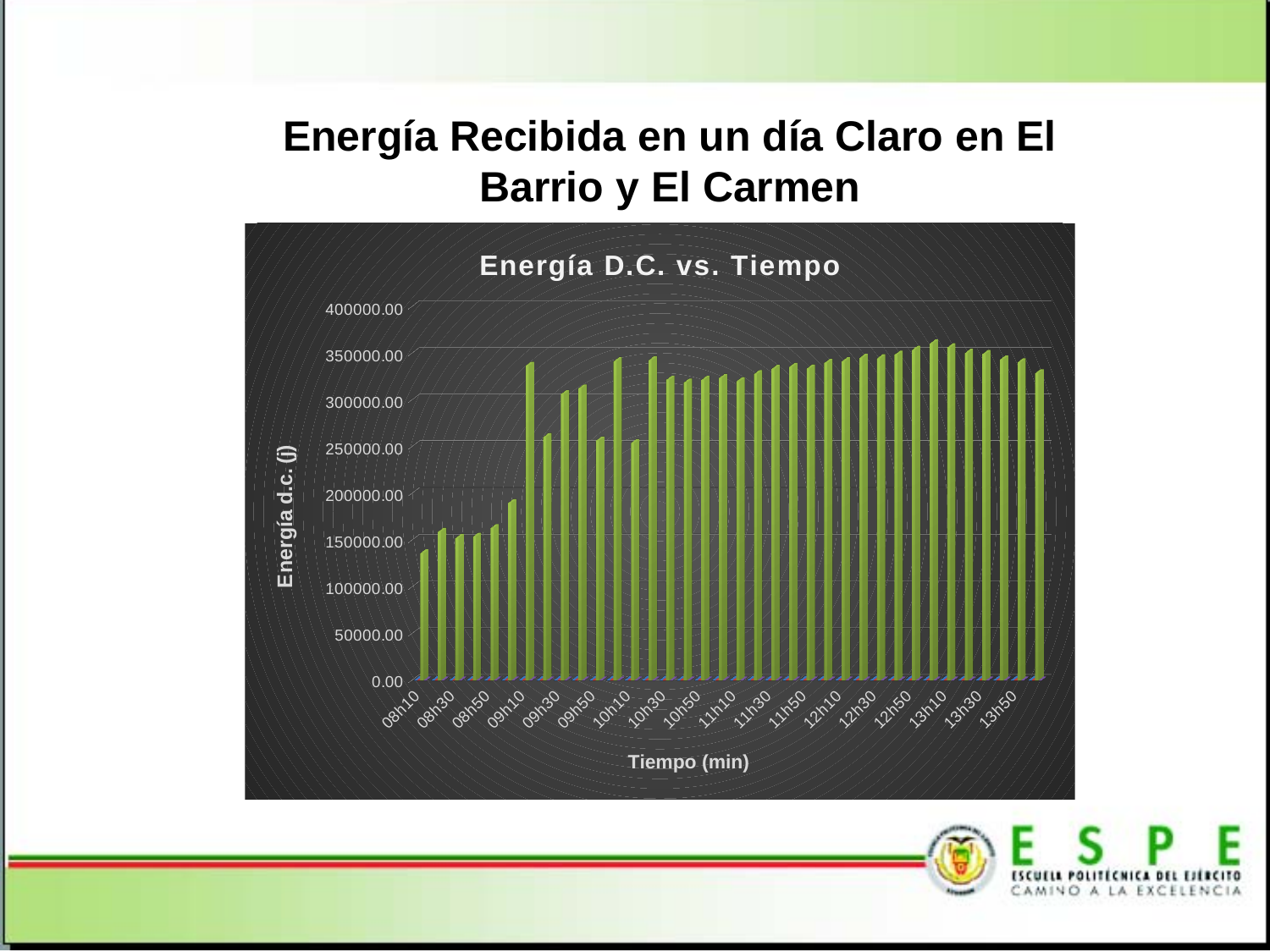
What is the highest value shown on the y axis? 400000.00 Which time label has the lowest energy value? 08h10 Is the value at 12h30 greater or less than 300000.00? greater What is the title of the chart? Energía D.C. vs. Tiempo How many time labels are shown on the x axis? 18 What type of chart is shown on the slide? bar chart What is the label of the x axis? Tiempo (min) Which is larger, the value at 08h10 or the value at 13h50? 13h50 Is the value at 08h10 greater or less than 150000.00? less Do the energy values generally rise or fall from 08h10 to 13h50? rise Is the value at 13h50 greater or less than 300000.00? greater